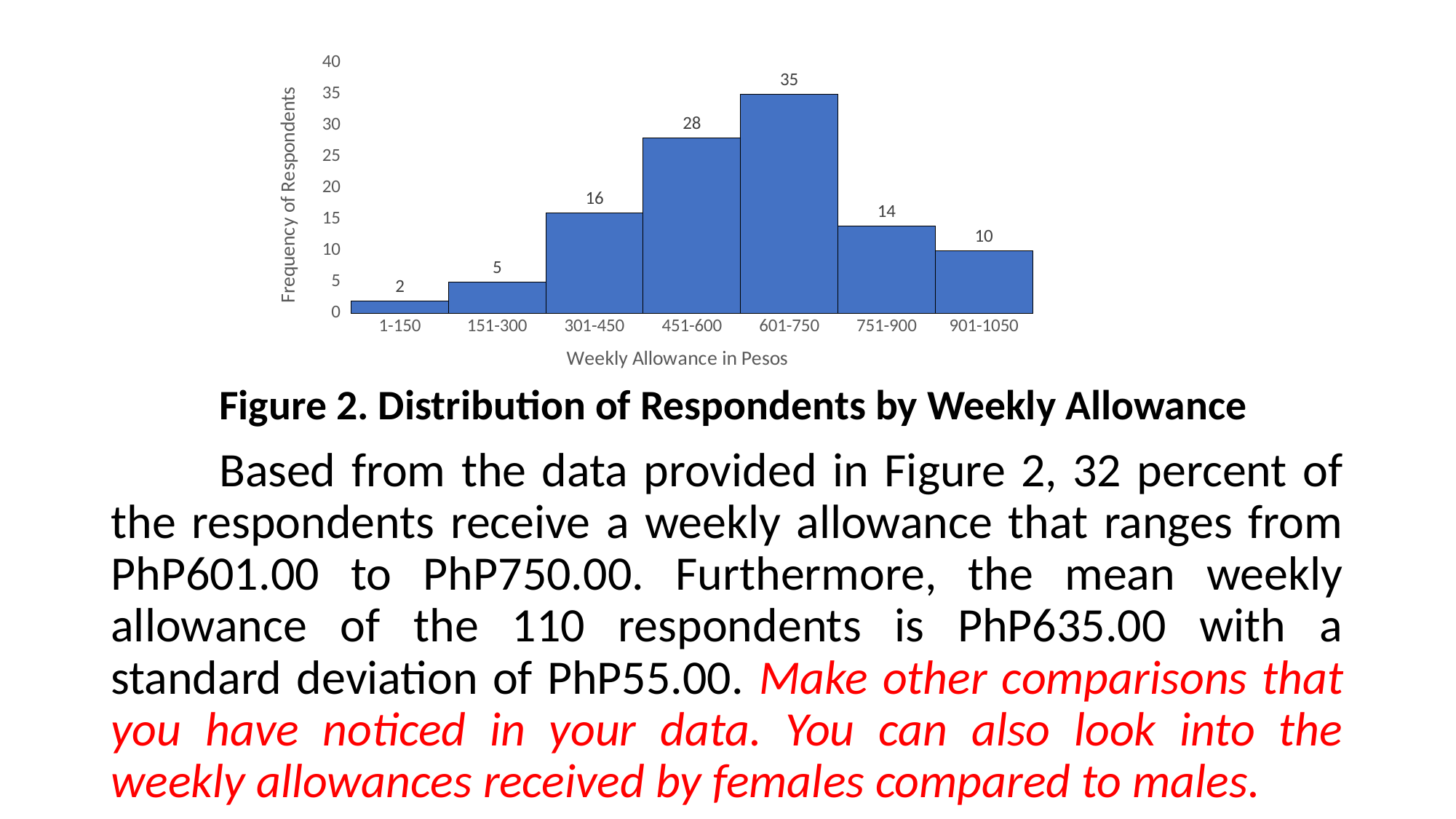
What is the difference in frequency between the 601-750 range and the 451-600 range? 7 Which has a higher frequency of respondents, the 751-900 range or the 901-1050 range? 751-900 What is the frequency of respondents for the 1-150 weekly allowance range? 2 Is the frequency for the 451-600 range greater or less than 25? greater What is the frequency of respondents for the 601-750 weekly allowance range? 35 How many weekly allowance ranges are shown on the x axis? 7 What is the frequency of respondents for the 901-1050 weekly allowance range? 10 Which weekly allowance range has the lowest frequency of respondents? 1-150 What is the label of the x axis of the chart? Weekly Allowance in Pesos What kind of chart is shown on the slide? Bar chart Which weekly allowance range has the highest frequency of respondents? 601-750 What is the difference in frequency between the 301-450 range and the 151-300 range? 11